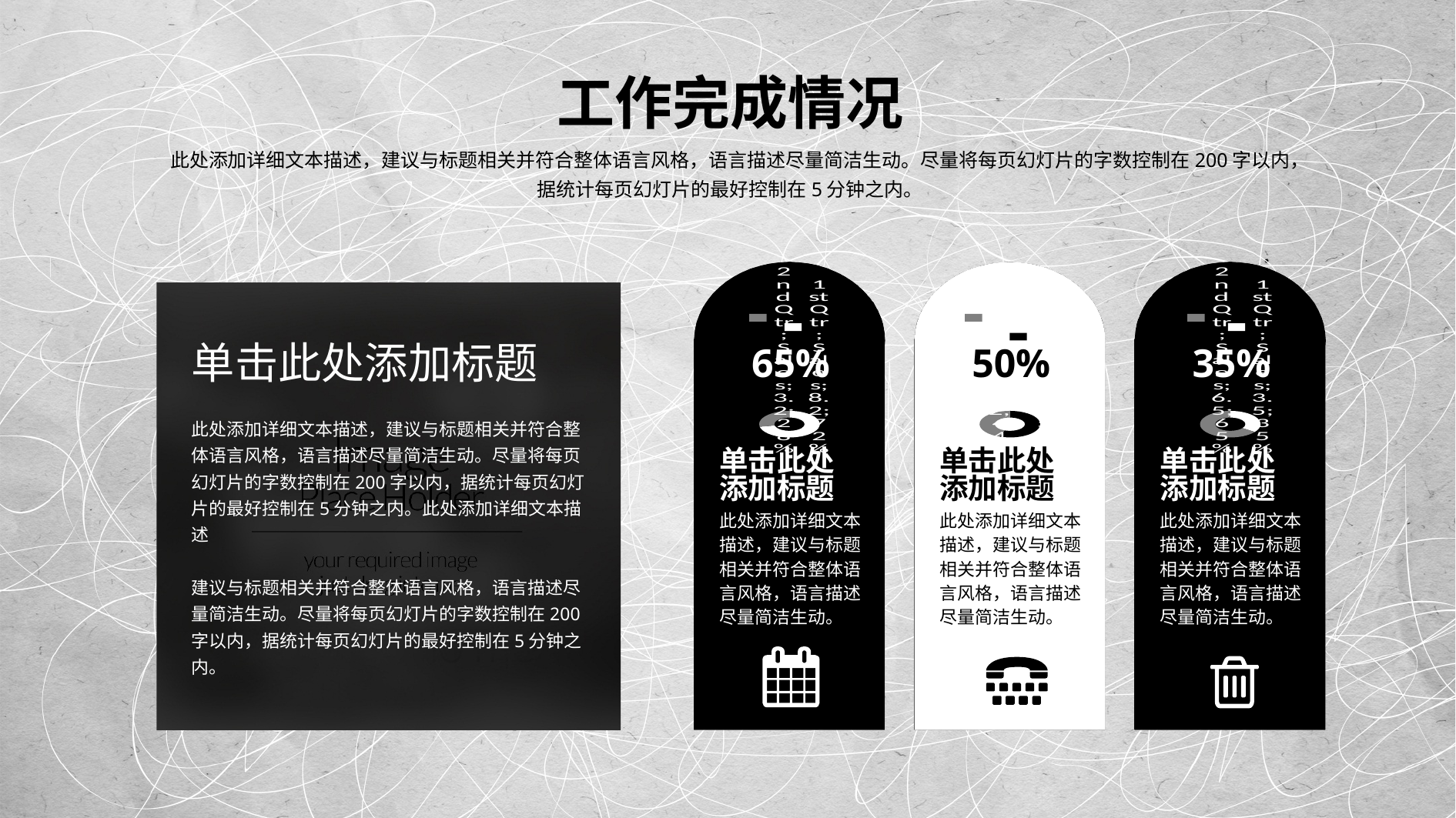
What is the difference between the percentage in the leftmost card and the percentage in the rightmost card? 30 percentage points Is the percentage in the leftmost card larger or smaller than the percentage in the rightmost card? larger What percentage is printed above the chart in the middle (white) rounded card? 50% What percentage is printed above the chart in the leftmost rounded card? 65% What is the background colour of the middle rounded card containing the 50% chart? white How many small charts are on the slide? 3 What percentage is printed above the chart in the rightmost rounded card? 35% What kind of chart is shown inside each of the three rounded cards on the right side of the slide? doughnut chart Which of the three rounded cards shows the lowest percentage? the rightmost card (35%) What is the difference between the percentage in the leftmost card and the percentage in the middle card? 15 percentage points Which of the three rounded cards shows the highest percentage? the leftmost card (65%)